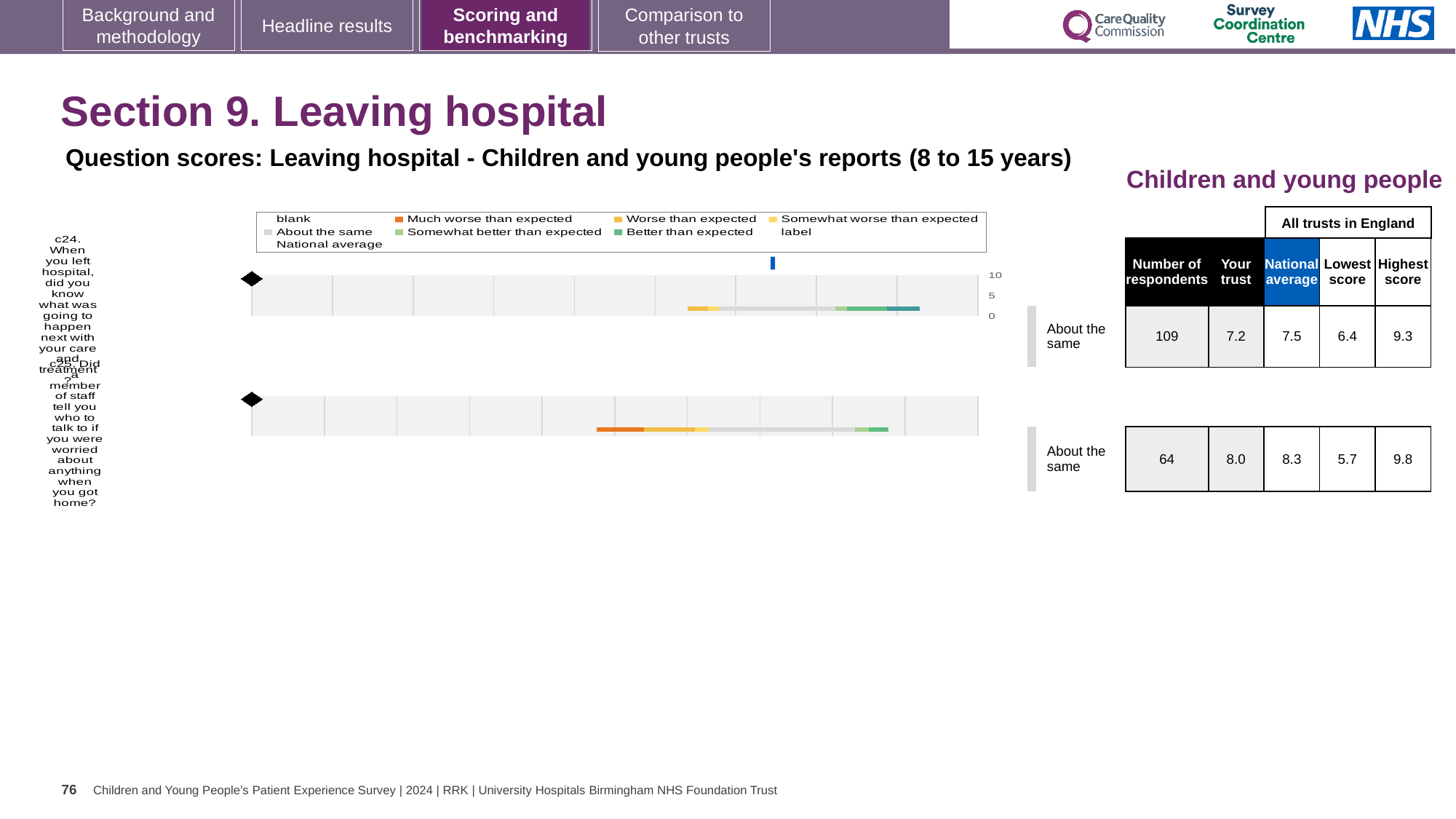
Which question has the lower 'Lowest score' in the table, c24 or c25? c25 For question c25, what is the 'National average' score shown in the table? 8.3 For question c25, what is the 'Highest score' shown in the table? 9.8 What is the highest tick value shown on the axis of the c24 chart? 10 For question c24, what is the 'Your trust' score shown in the table? 7.2 What benchmark category label is shown next to the c24 chart? About the same For question c24, how many respondents are shown in the table? 109 What kind of chart is used for question c24 on the slide? bar chart For question c25, what is the difference between the 'National average' and 'Your trust' scores? 0.3 How many survey questions (charts) are shown on the slide? 2 Which question has the higher 'Your trust' score, c24 or c25? c25 How many entries does the legend above the charts list? 9